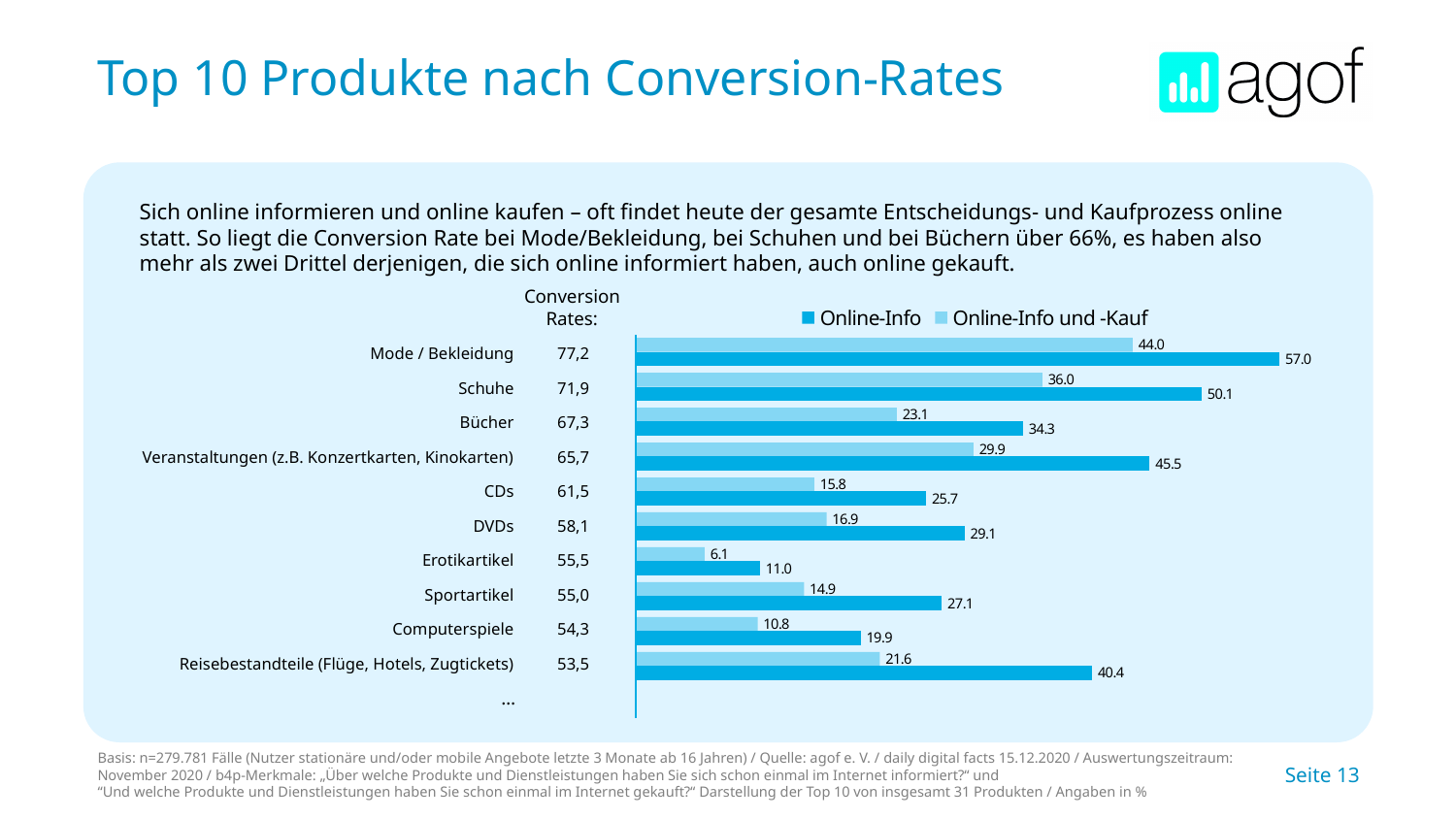
Which category has the lowest Online-Info und -Kauf value? Erotikartikel What is the Online-Info value for Reisebestandteile (Flüge, Hotels, Zugtickets)? 40.4 What is the Online-Info und -Kauf value for Computerspiele? 10.8 Which category has the highest Online-Info value? Mode / Bekleidung How many product categories are plotted in the chart? 10 What is the difference between the Online-Info and Online-Info und -Kauf values for Veranstaltungen (z.B. Konzertkarten, Kinokarten)? 15.6 What is the Online-Info value for Mode / Bekleidung? 57.0 Which is larger: the Online-Info value for DVDs or the Online-Info value for CDs? DVDs Which series is shown in the darker blue colour in the chart? Online-Info What is the Online-Info und -Kauf value for Schuhe? 36.0 How many series does the chart legend list? 2 What kind of chart is shown on the slide? Bar chart